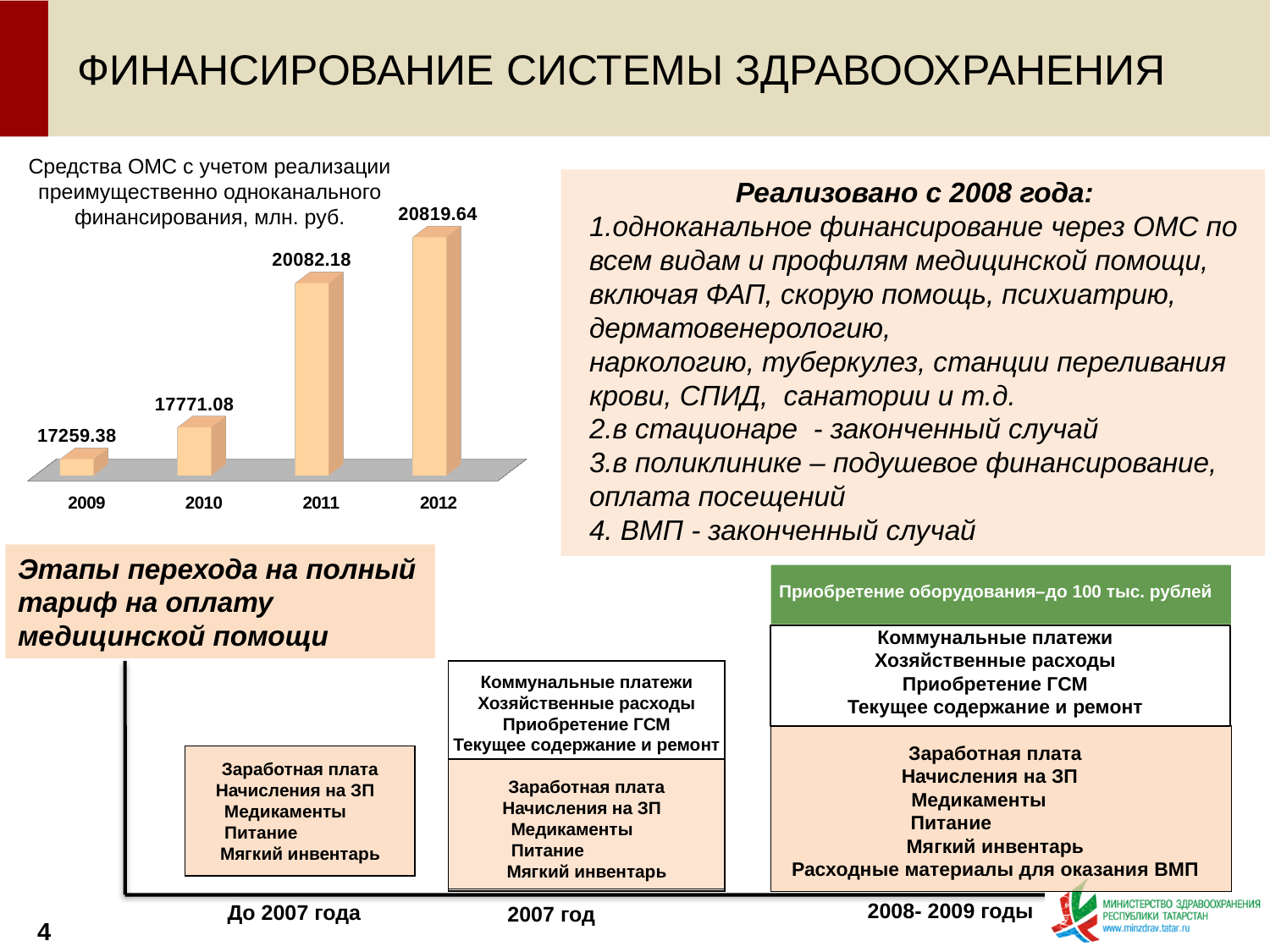
How many years are shown in the chart? 4 What is the difference between the values for 2011 and 2010? 2311.10 What is the value for 2012 in the chart? 20819.64 What is the value for 2011 in the chart? 20082.18 Which year has the highest value in the chart? 2012 What is the value for 2010 in the chart? 17771.08 Do the values rise or fall from 2009 to 2012? rise Which is larger, the value for 2010 or the value for 2011? 2011 What type of chart is shown on the slide? bar chart Which year has the lowest value in the chart? 2009 What is the value for 2009 in the chart? 17259.38 What is the difference between the values for 2012 and 2011? 737.46